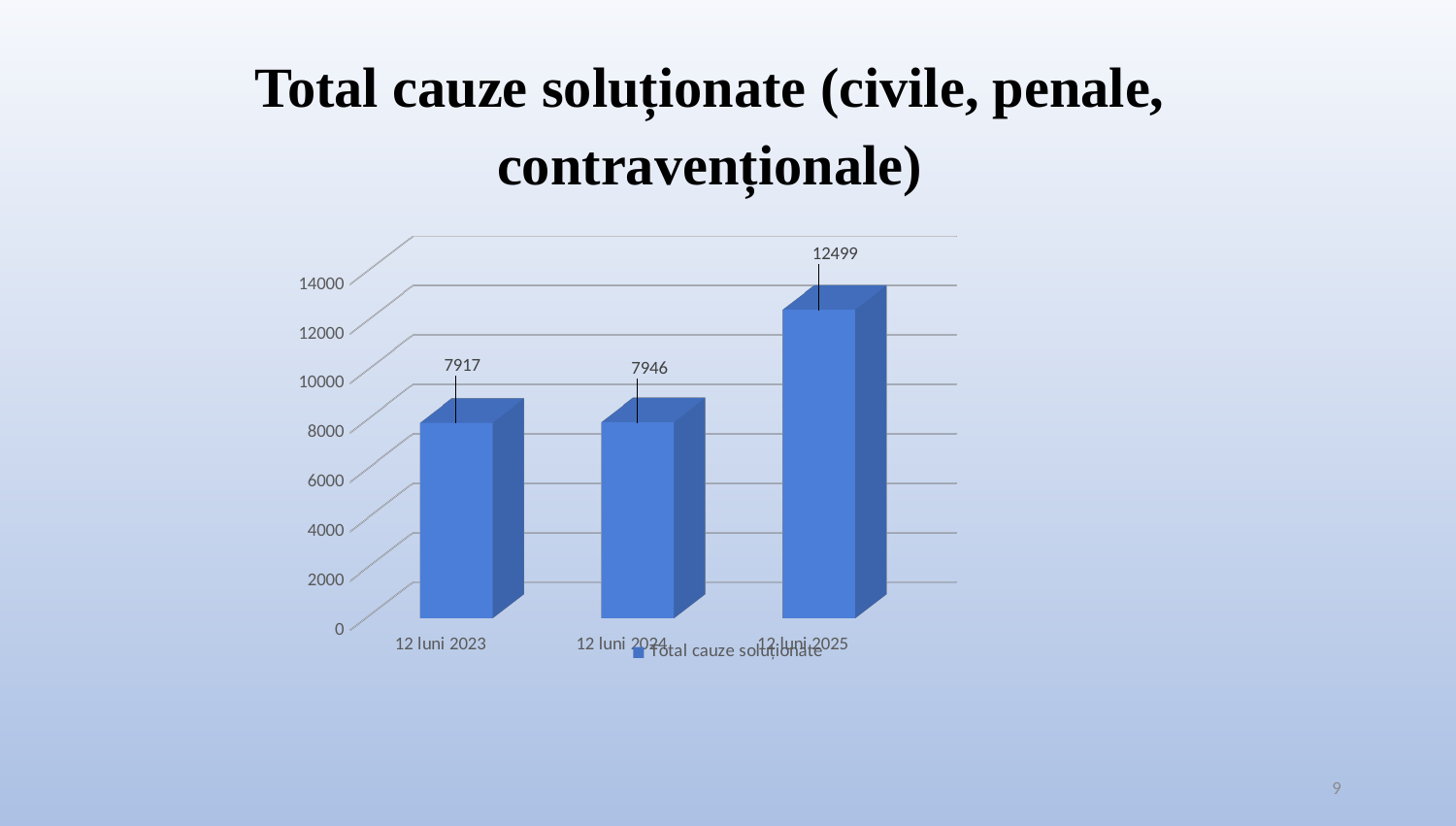
Which category has the highest value? 12 luni 2025 Which category has the lowest value? 12 luni 2023 What is the difference between the values for 12 luni 2024 and 12 luni 2023? 29 What kind of chart is shown on the slide? bar chart Which is larger, the value for 12 luni 2025 or the value for 12 luni 2023? 12 luni 2025 What is the value for 12 luni 2025? 12499 How many categories are shown on the x axis? 3 What is the value for 12 luni 2023? 7917 Is the value for 12 luni 2025 greater or less than 10000? greater What is the legend entry shown below the chart? Total cauze soluționate What is the value for 12 luni 2024? 7946 What is the difference between the values for 12 luni 2025 and 12 luni 2024? 4553